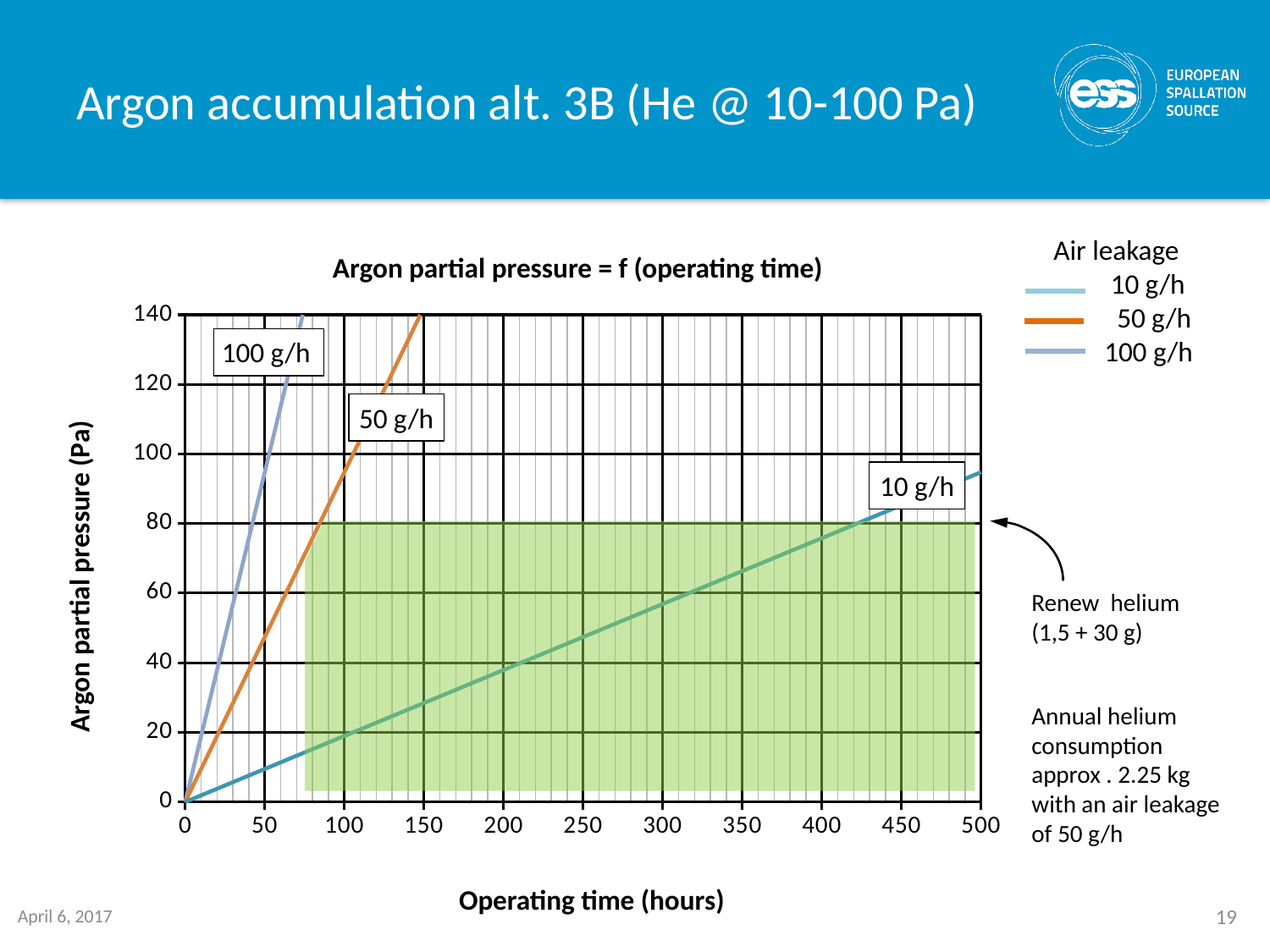
Do the argon partial pressure values rise or fall as operating time increases? rise Is the argon partial pressure for the 50 g/h series at 100 hours greater or less than 80? greater Which air leakage series rises most steeply? 100 g/h How many series does the legend list? 3 Is the argon partial pressure for the 100 g/h series at 50 hours greater or less than 80? greater What is the label of the x axis? Operating time (hours) Is the argon partial pressure for the 10 g/h series at 250 hours greater or less than 60? less Which air leakage series rises least steeply? 10 g/h What kind of chart is shown on the slide? line chart At 100 hours, which series has the higher argon partial pressure, 50 g/h or 10 g/h? 50 g/h What is the title of the chart? Argon partial pressure = f (operating time)